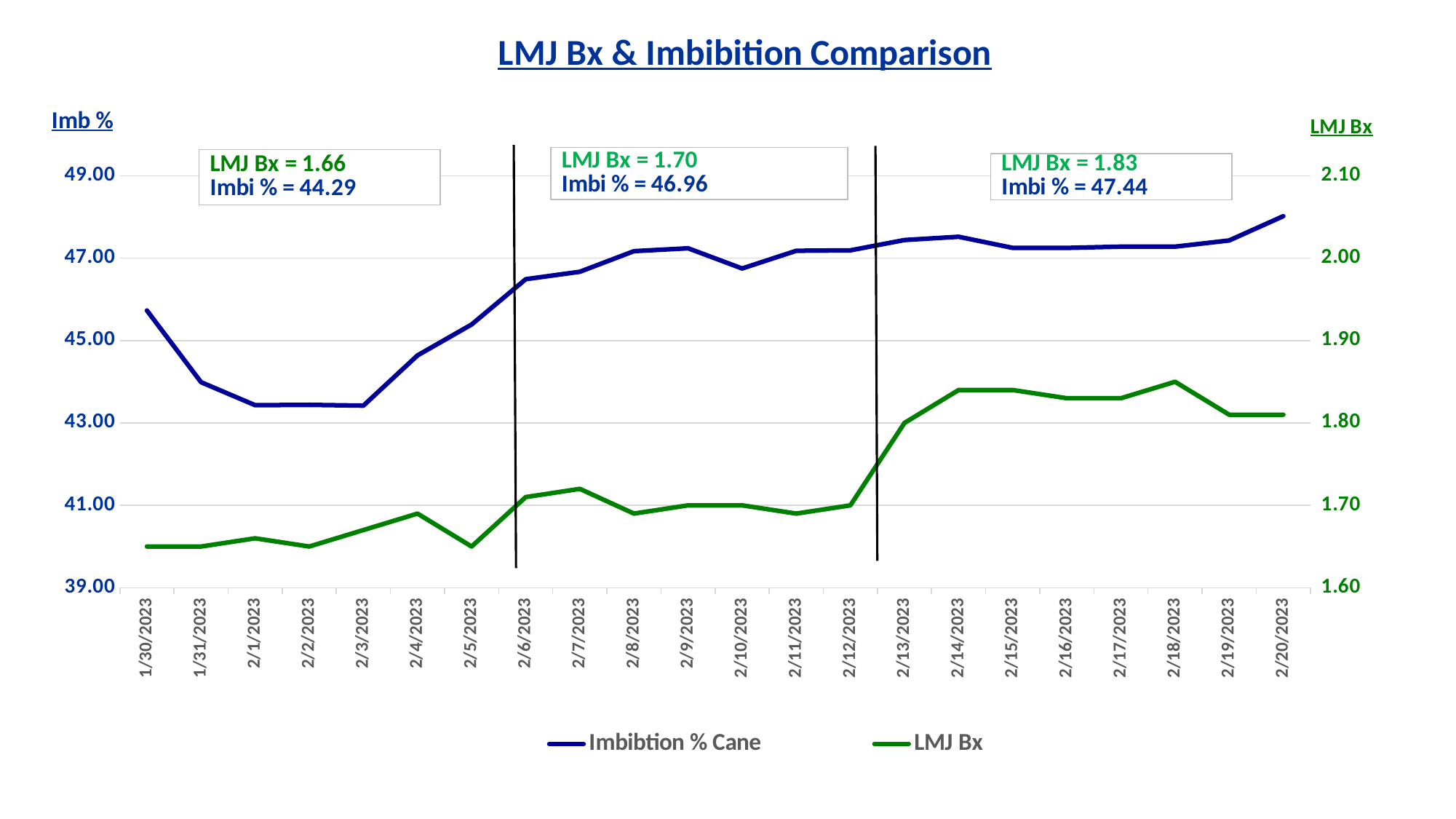
What is the difference between the LMJ Bx values in the third-period and first-period text boxes (1.83 and 1.66)? 0.17 What is the LMJ Bx value given in the text box for the first period (left section)? 1.66 What is the Imbi % value given in the text box for the third period (right section)? 47.44 How many series does the legend list? 2 On which date is the Imbibtion % Cane value highest? 2/20/2023 What kind of chart is shown on the slide? line chart Is the LMJ Bx value on 2/14/2023 greater or less than 1.80? greater Does the LMJ Bx line rise or fall from 2/12/2023 to 2/14/2023? rise How many dates are plotted along the x axis? 22 Is the Imbibtion % Cane value on 2/1/2023 greater or less than 45.00? less What is the Imbi % value given in the text box for the middle period? 46.96 Which is larger, the Imbibtion % Cane value on 1/30/2023 or on 2/1/2023? 1/30/2023